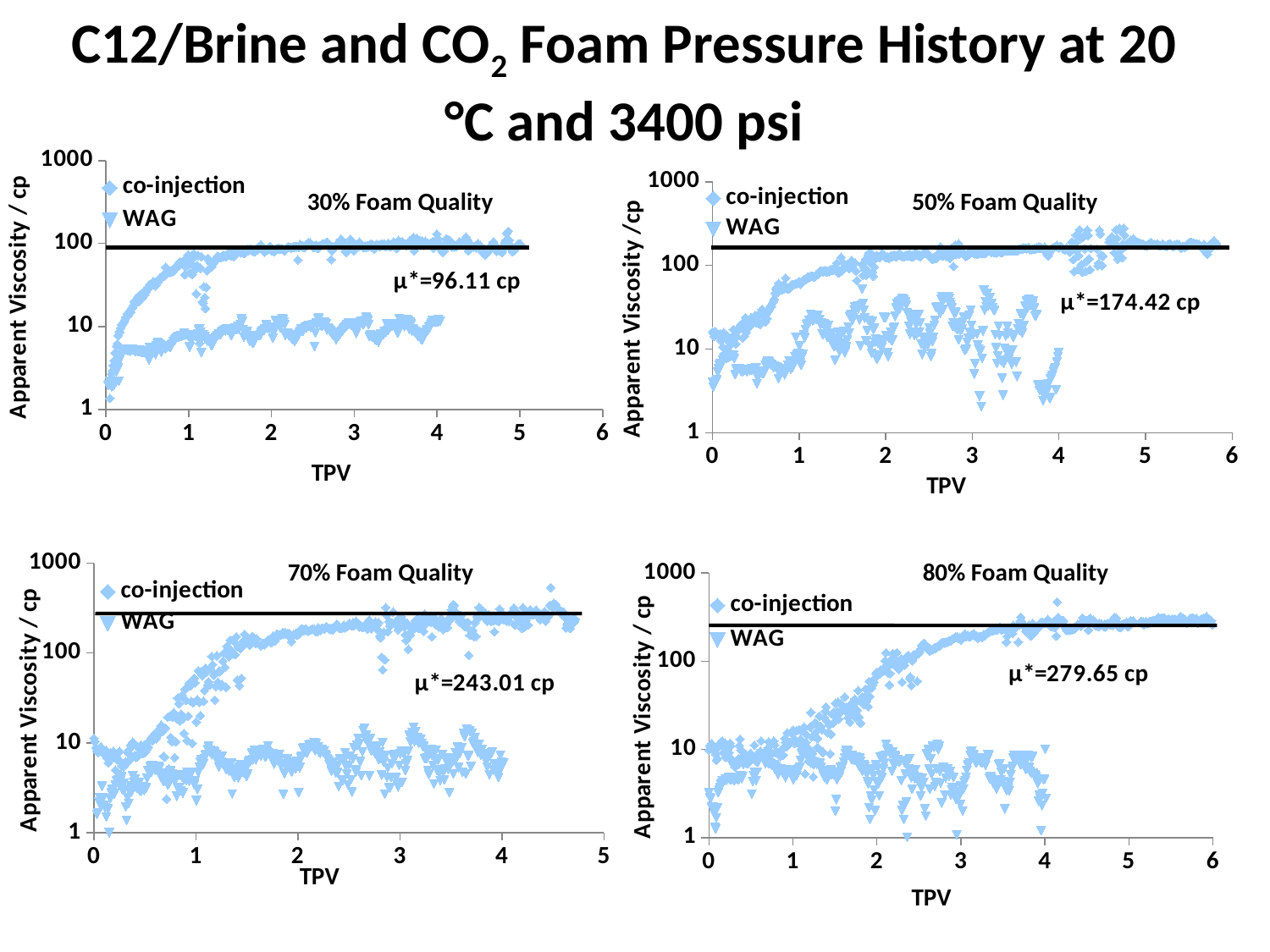
In the 80% Foam Quality chart, what is the value of μ* shown? 279.65 cp In the 30% Foam Quality chart, is the WAG apparent viscosity at TPV 3 greater or less than 100? less In the 70% Foam Quality chart, how many series does the legend list? 2 In the 80% Foam Quality chart, does the co-injection apparent viscosity rise or fall as TPV increases from 0 to 4? Rise What is the difference between the μ* value in the 80% Foam Quality chart and the μ* value in the 30% Foam Quality chart? 183.54 cp In the 30% Foam Quality chart, what is the value of μ* shown? 96.11 cp How many charts are shown on the slide? 4 Across the four charts, which foam quality has the lowest μ* value? 30% Foam Quality Across the four charts, which foam quality has the highest μ* value? 80% Foam Quality In the 50% Foam Quality chart, what is the value of μ* shown? 174.42 cp What kind of chart is the 30% Foam Quality chart? Scatter chart Which has a larger μ* value: the 50% Foam Quality chart or the 70% Foam Quality chart? 70% Foam Quality